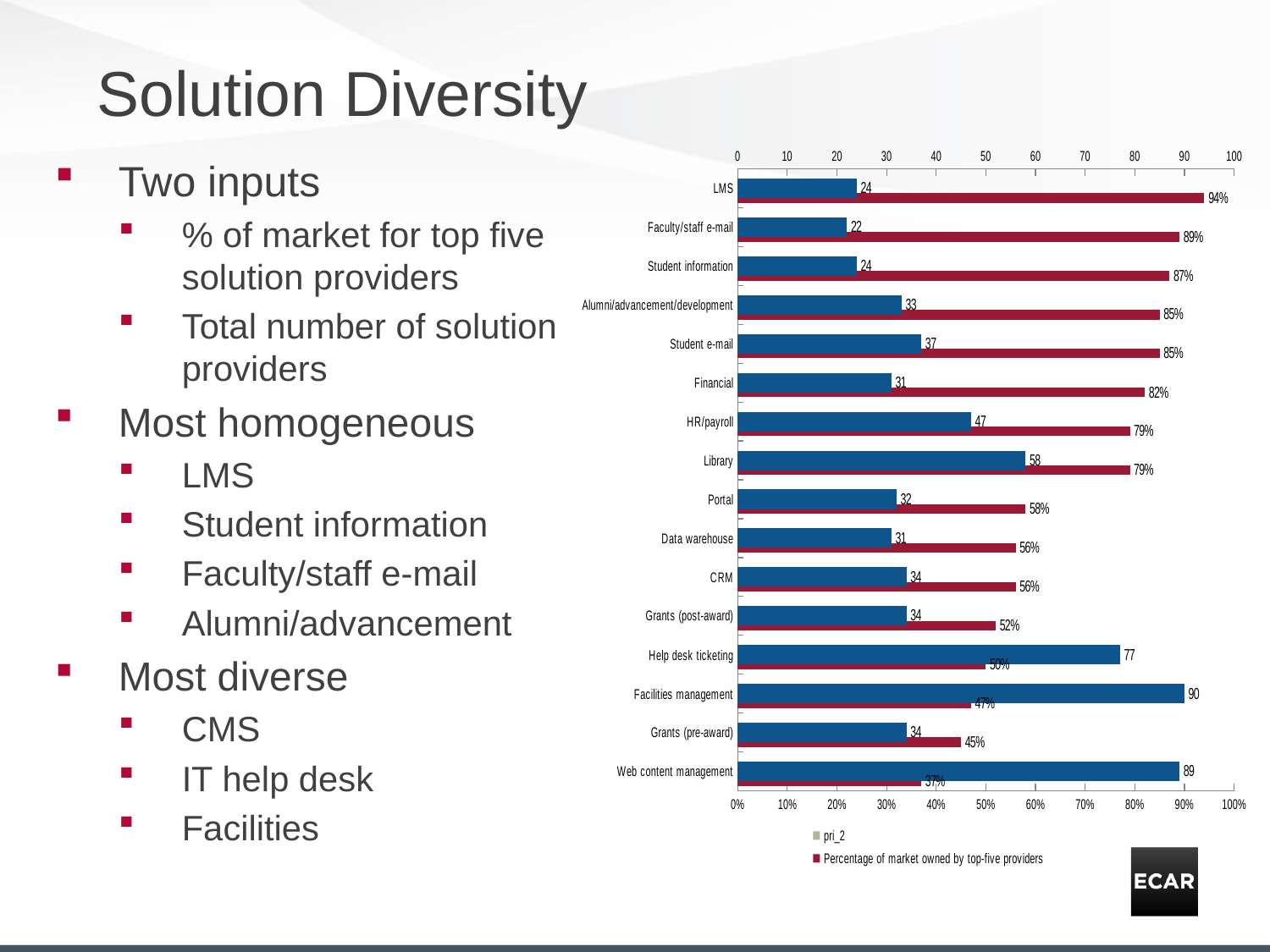
What percentage of the market is owned by top-five providers for Web content management? 37% What percentage of the market is owned by top-five providers for LMS? 94% What is the difference between the percentage of market owned by top-five providers for LMS and for Web content management? 57% What colour are the bars for the series 'Percentage of market owned by top-five providers'? Red Which has a larger blue (pri_2) value, Help desk ticketing or Library? Help desk ticketing Which category has the lowest value for the blue (pri_2) series? Faculty/staff e-mail How many categories are shown on the chart? 16 What kind of chart is shown on the slide? Bar chart Which category has the highest percentage of market owned by top-five providers? LMS What is the blue (pri_2) value for HR/payroll? 47 What is the value of the blue (pri_2) bar for Facilities management? 90 How many series does the legend list? 2